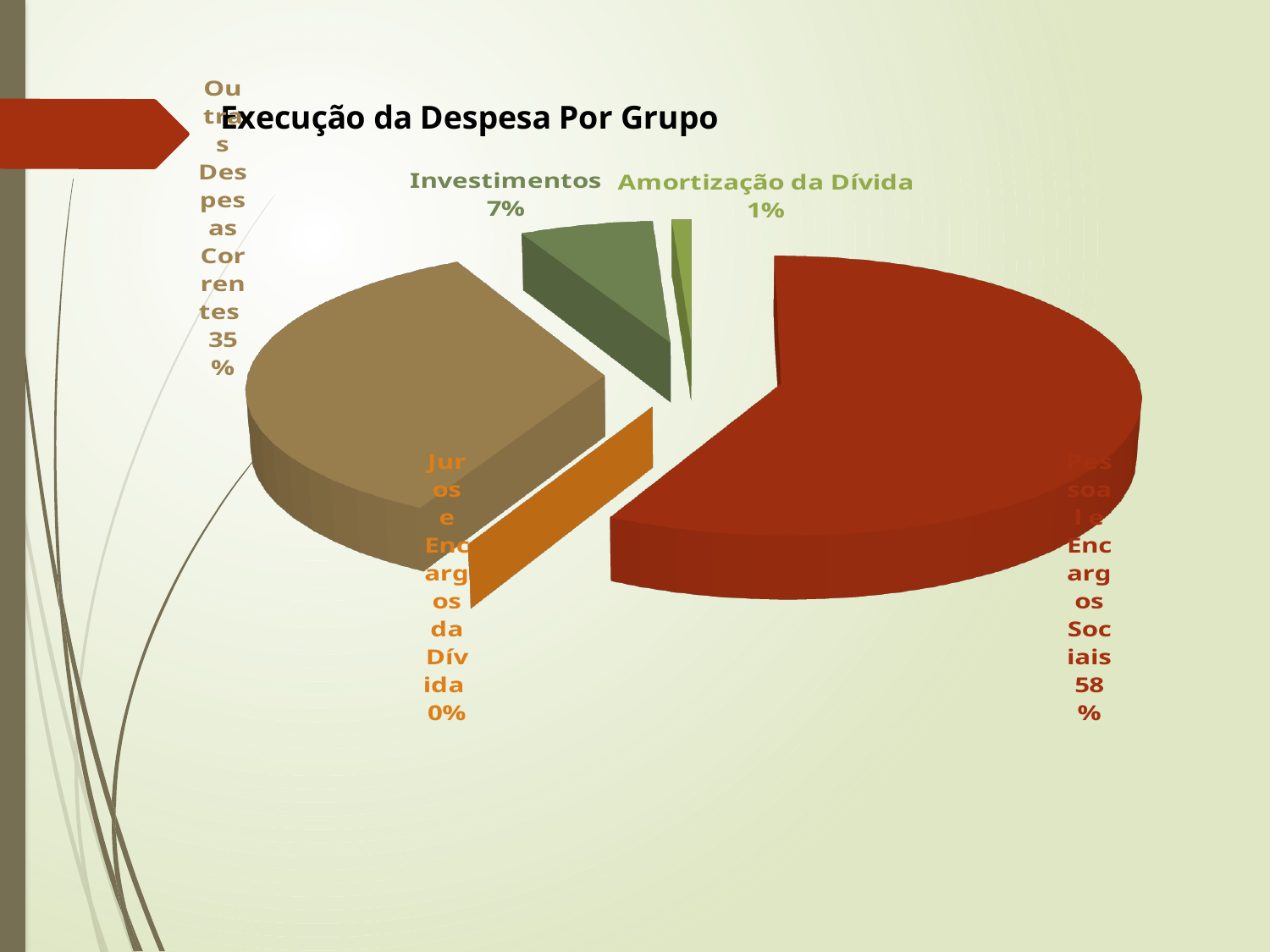
What share of the pie does Pessoal e Encargos Sociais represent? 58% Which group has the largest share of the pie? Pessoal e Encargos Sociais What is the difference in percentage points between Pessoal e Encargos Sociais and Outras Despesas Correntes? 23 What is the title of the chart? Execução da Despesa Por Grupo Which is larger, the share for Investimentos or the share for Amortização da Dívida? Investimentos Which group has the smallest share of the pie? Juros e Encargos da Dívida What share of the pie does Amortização da Dívida represent? 1% How many slices does the pie chart have? 5 What share of the pie does Outras Despesas Correntes represent? 35% What share of the pie does Juros e Encargos da Dívida represent? 0% What share of the pie does Investimentos represent? 7% What kind of chart is shown on the slide? pie chart